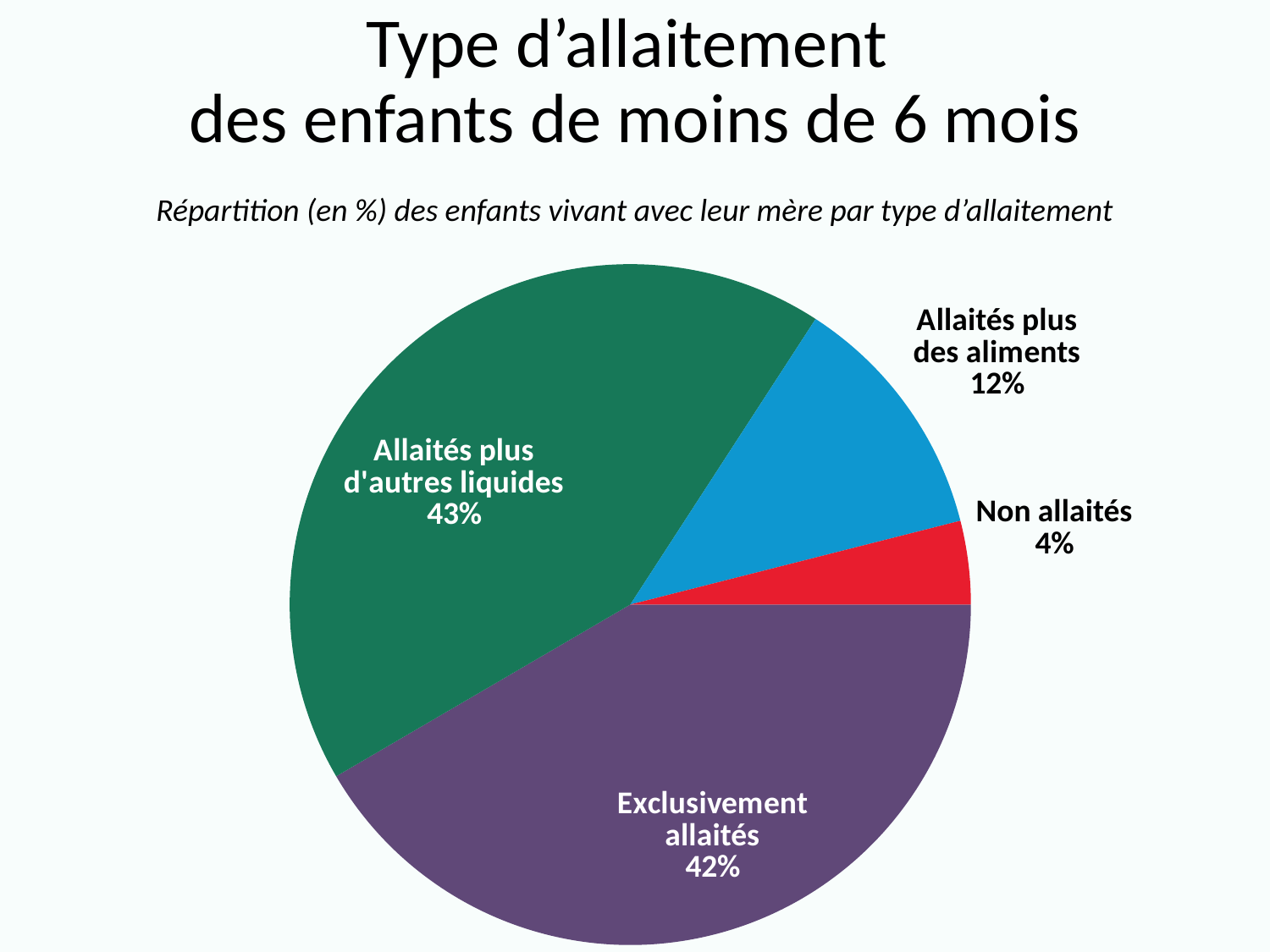
Which is larger: the share for 'Allaités plus des aliments' or the share for 'Non allaités'? Allaités plus des aliments What kind of chart is shown on the slide? Pie chart Which category has the largest share of the pie? Allaités plus d'autres liquides What percentage of children are 'Allaités plus d'autres liquides'? 43% How many categories are shown in the pie chart? 4 Which category has the smallest share of the pie? Non allaités What percentage of children are 'Allaités plus des aliments'? 12% What percentage of children are 'Non allaités'? 4% What is the title of the chart? Type d'allaitement des enfants de moins de 6 mois What is the difference in percentage points between 'Allaités plus des aliments' and 'Non allaités'? 8 What percentage of children are 'Exclusivement allaités'? 42% What is the difference in percentage points between 'Exclusivement allaités' and 'Allaités plus des aliments'? 30